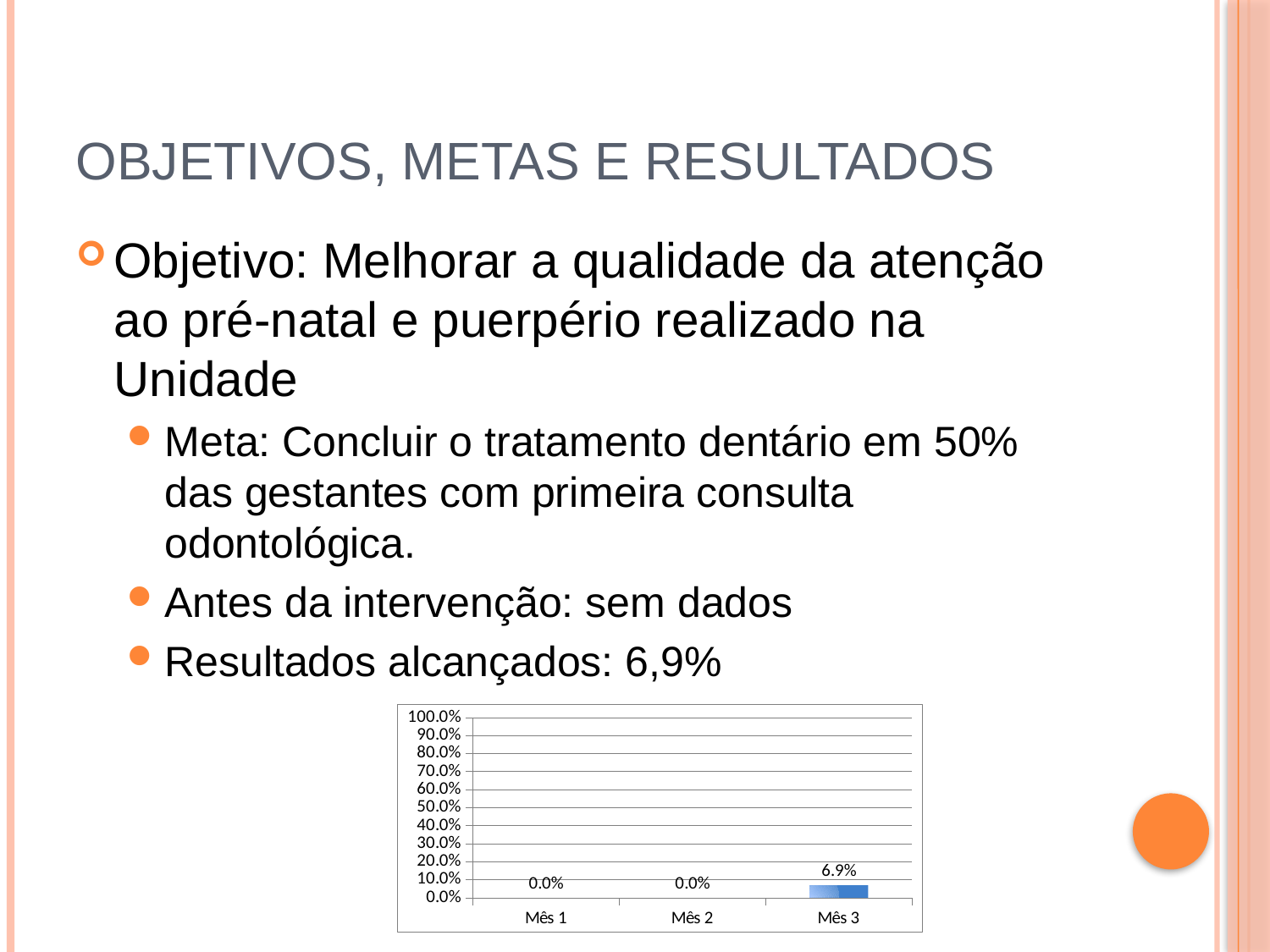
Which category has the highest value in the chart? Mês 3 What is the maximum value shown on the y axis of the chart? 100.0% How many categories are shown on the x axis of the chart? 3 What kind of chart is shown on the slide? bar chart What is the value for Mês 2 in the chart? 0.0% What is the value for Mês 1 in the chart? 0.0% What is the difference between the values for Mês 3 and Mês 2? 6.9% Is the value for Mês 3 greater or less than 10.0%? less Which is larger, the value for Mês 3 or the value for Mês 1? Mês 3 What is the value for Mês 3 in the chart? 6.9% Do the values rise or fall from Mês 1 to Mês 3? rise What colour is the bar for Mês 3? blue